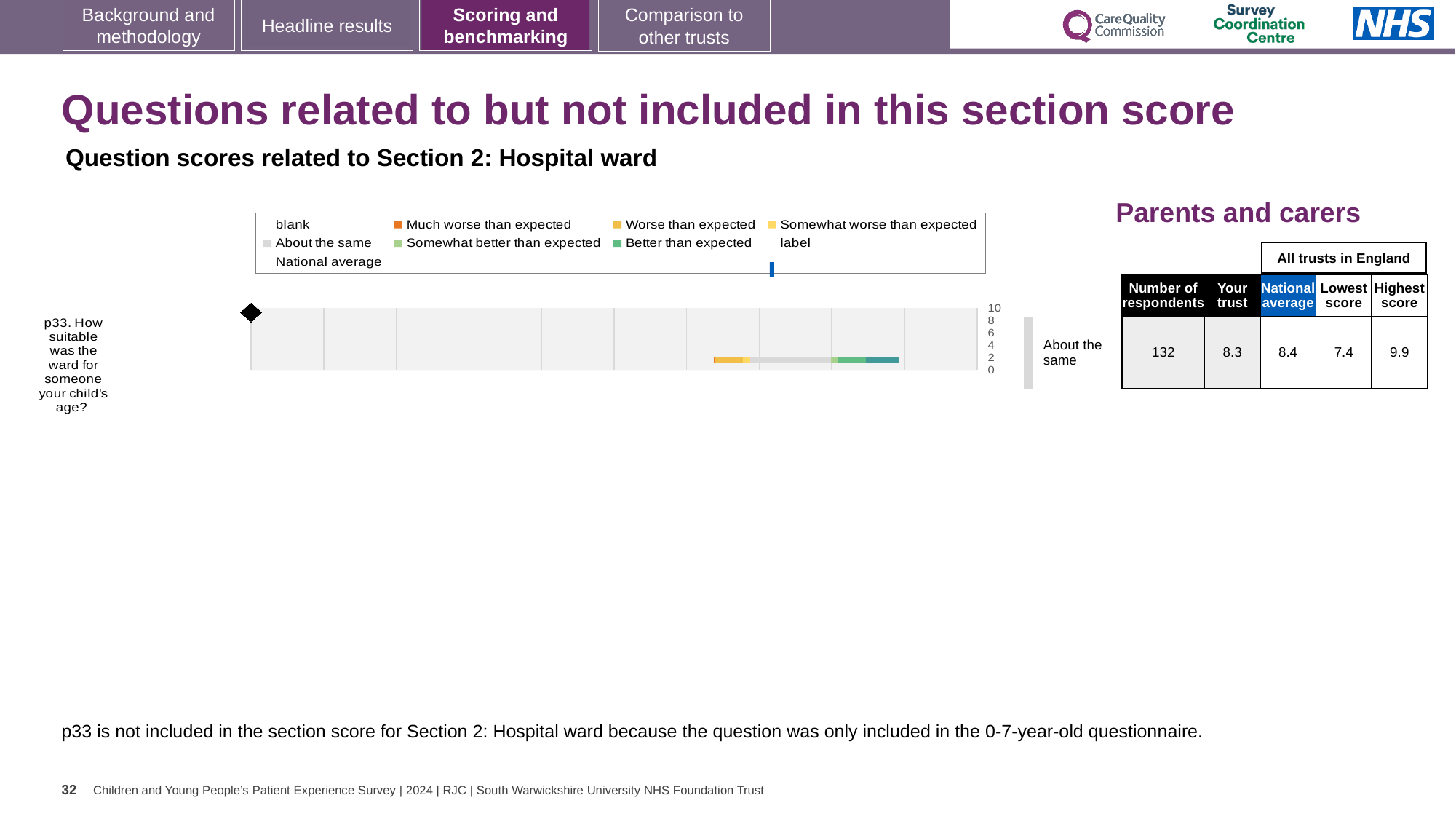
What is the 'Your trust' score for p33 in the table? 8.3 How many questions are plotted in the chart? 1 What is the highest score among all trusts in England for p33? 9.9 What is the lowest score among all trusts in England for p33? 7.4 What is the highest value shown on the chart's score axis? 10 What is the difference between the highest and lowest scores for p33 across all trusts in England? 2.5 Which is larger for p33, the trust's score or the national average? national average What benchmark category label is shown next to the bar for p33? About the same What is the national average score for p33? 8.4 What kind of chart is shown for question p33? bar chart Which legend entry is shown in orange? Much worse than expected How many respondents answered p33? 132